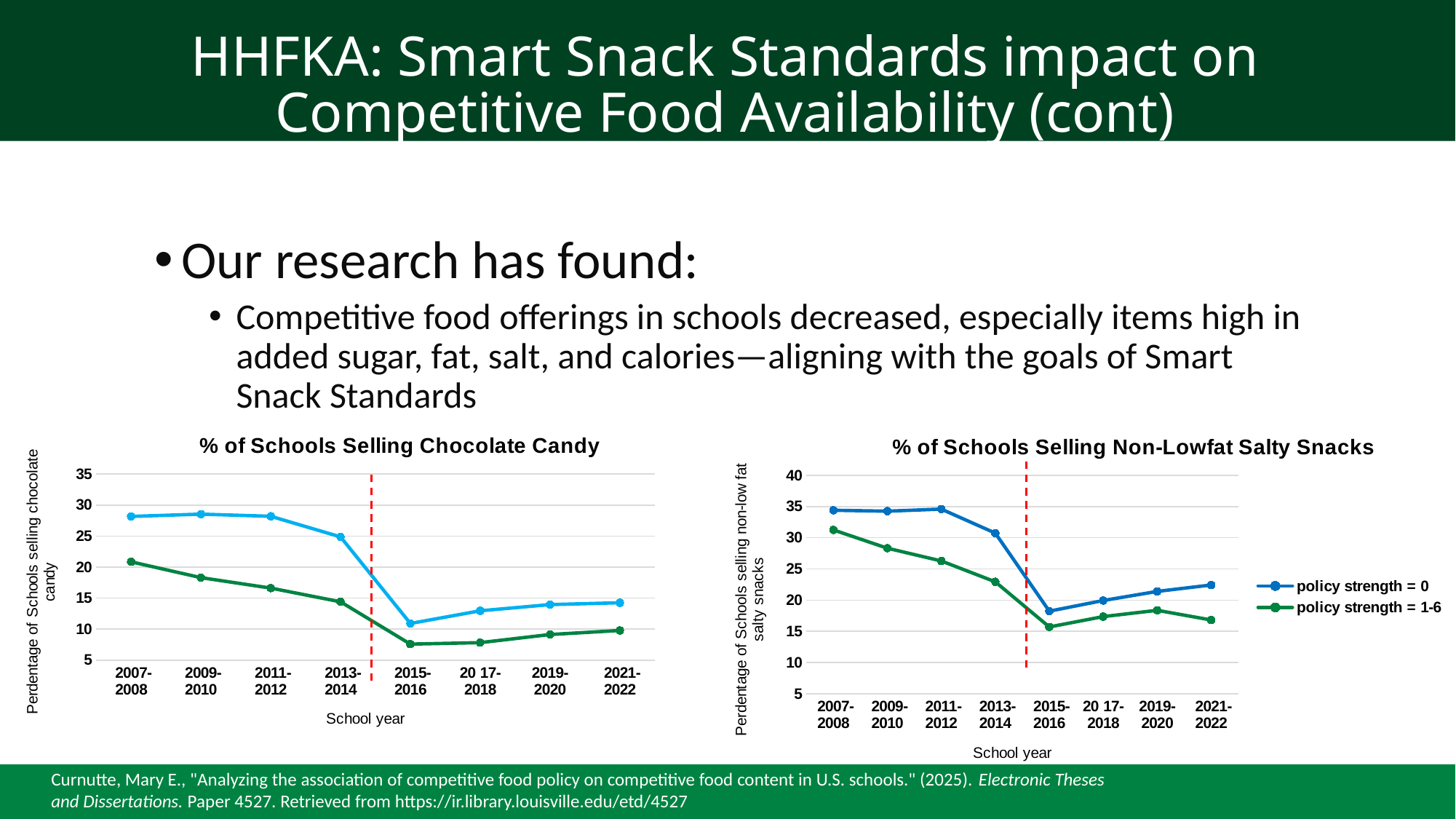
How many series does the legend of the '% of Schools Selling Non-Lowfat Salty Snacks' chart list? 2 In the '% of Schools Selling Non-Lowfat Salty Snacks' chart, is the 'policy strength = 1-6' value for 2007-2008 greater or less than 25? greater In the '% of Schools Selling Chocolate Candy' chart, is the value of the lower (green) line for 2015-2016 greater or less than 10? less In the '% of Schools Selling Non-Lowfat Salty Snacks' chart, in which school year is the 'policy strength = 1-6' line at its highest? 2007-2008 In the '% of Schools Selling Chocolate Candy' chart, is the value of the upper (blue) line for 2007-2008 greater or less than 25? greater In the '% of Schools Selling Non-Lowfat Salty Snacks' chart, which series has the higher value in 2021-2022, 'policy strength = 0' or 'policy strength = 1-6'? policy strength = 0 How many school years are shown on the x axis of the '% of Schools Selling Non-Lowfat Salty Snacks' chart? 8 In the '% of Schools Selling Chocolate Candy' chart, does the upper (blue) line rise or fall from 2007-2008 to 2015-2016? fall What type of chart is the '% of Schools Selling Chocolate Candy' chart? line chart In the '% of Schools Selling Non-Lowfat Salty Snacks' chart, in which school year is the 'policy strength = 0' line at its lowest? 2015-2016 In the '% of Schools Selling Non-Lowfat Salty Snacks' chart, what are the two legend entries? policy strength = 0; policy strength = 1-6